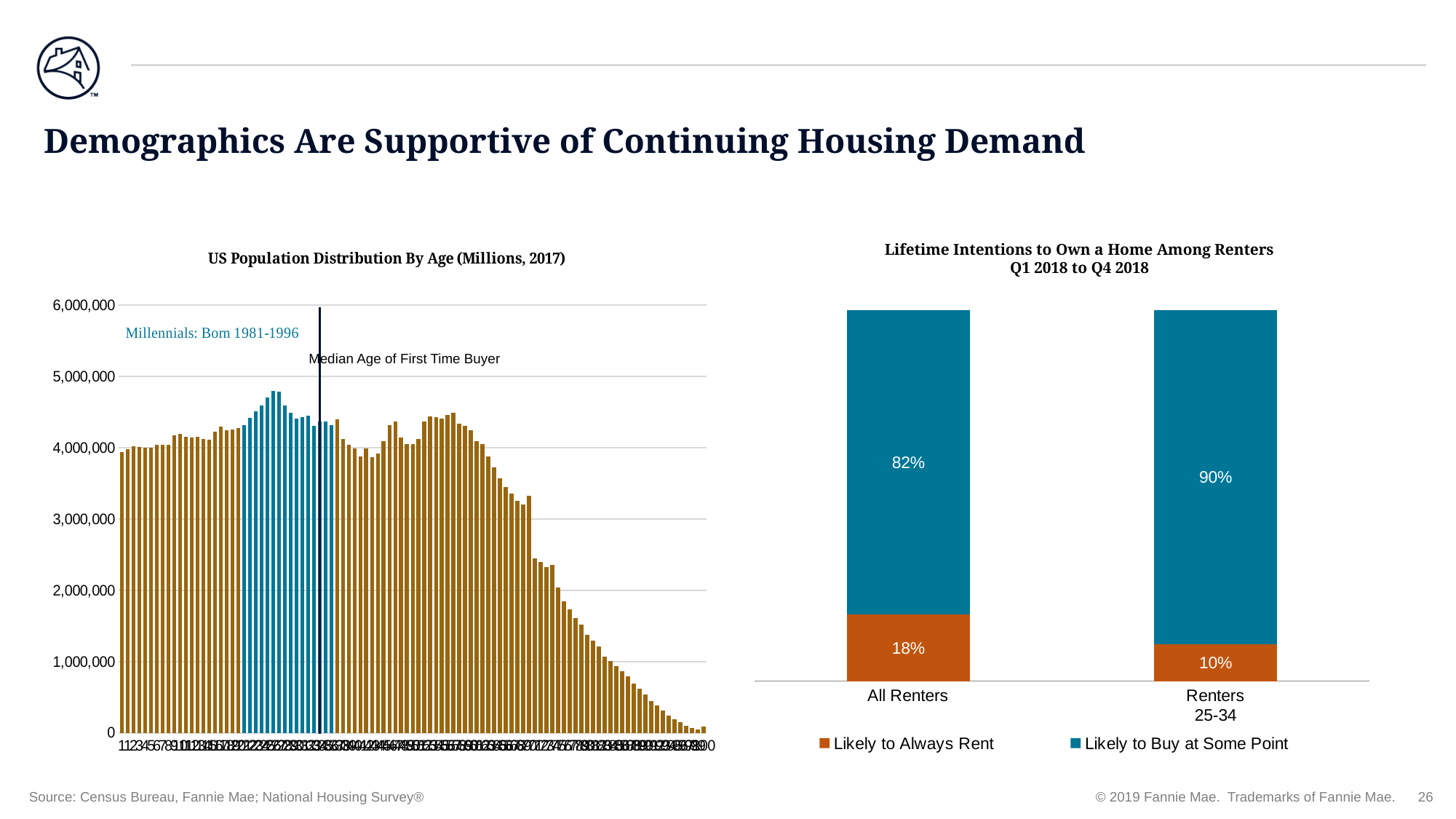
In the 'Lifetime Intentions to Own a Home Among Renters' chart, what percentage of All Renters are Likely to Buy at Some Point? 82% In the 'US Population Distribution By Age' chart, what birth years does the annotation give for Millennials? Born 1981-1996 In the 'US Population Distribution By Age' chart, is the tallest bar greater or less than 5,000,000? less In the 'Lifetime Intentions to Own a Home Among Renters' chart, which group has the higher share Likely to Buy at Some Point, All Renters or Renters 25-34? Renters 25-34 How many categories are shown on the x axis of the 'Lifetime Intentions to Own a Home Among Renters' chart? 2 How many series does the legend of the 'Lifetime Intentions to Own a Home Among Renters' chart list? 2 In the 'Lifetime Intentions to Own a Home Among Renters' chart, what is the difference in the Likely to Always Rent share between All Renters and Renters 25-34? 8% What kind of chart is the 'US Population Distribution By Age (Millions, 2017)' chart on the left? Bar chart In the 'Lifetime Intentions to Own a Home Among Renters' chart, what percentage of Renters 25-34 are Likely to Buy at Some Point? 90% In the 'Lifetime Intentions to Own a Home Among Renters' chart, what percentage of All Renters are Likely to Always Rent? 18% In the 'Lifetime Intentions to Own a Home Among Renters' chart, what percentage of Renters 25-34 are Likely to Always Rent? 10% In the 'Lifetime Intentions to Own a Home Among Renters' chart, what is the total of the two segments in the All Renters bar? 100%